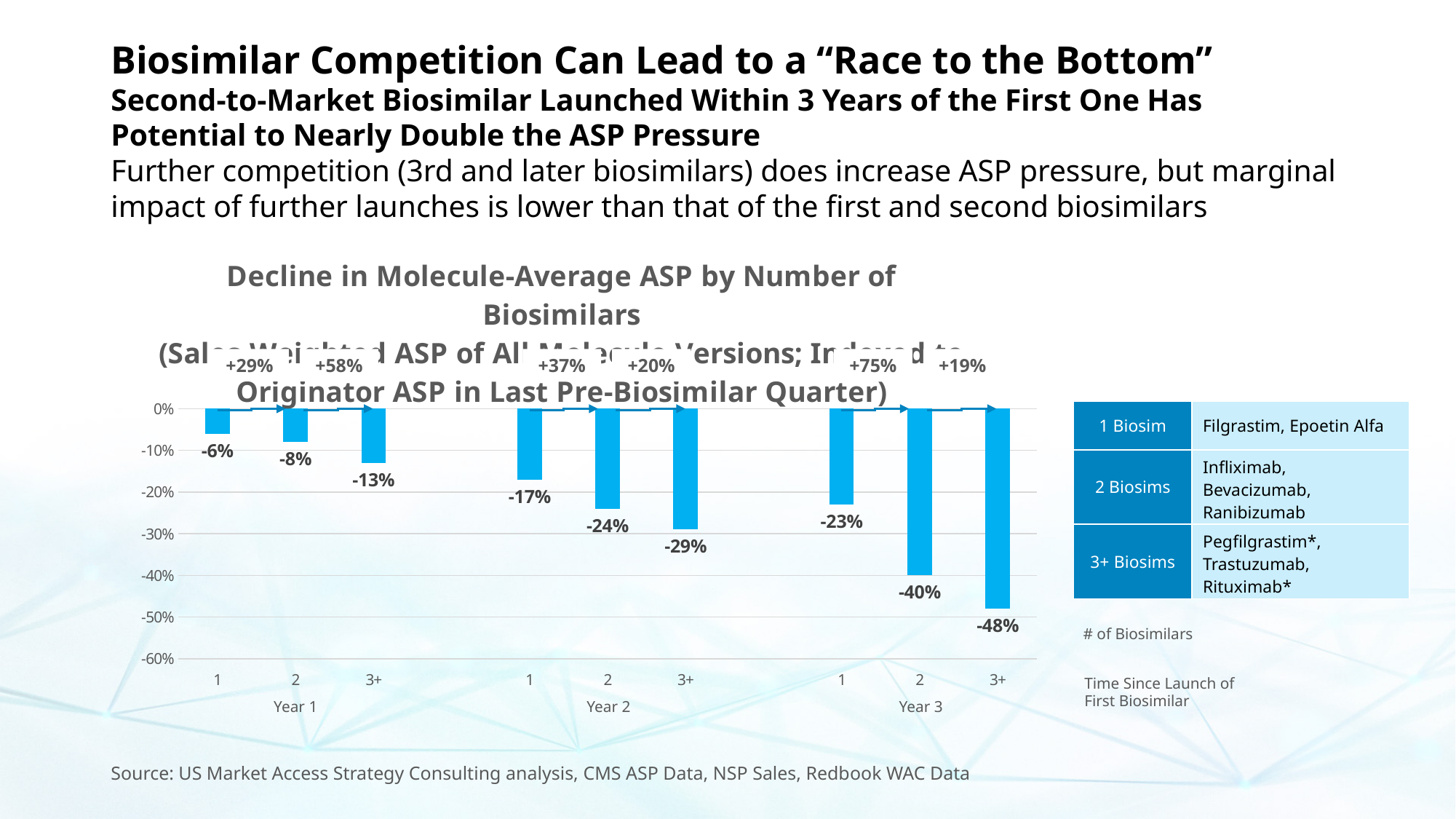
Which molecules are listed in the table for the 1 Biosim group? Filgrastim, Epoetin Alfa What is the ASP decline for 3+ biosimilars in Year 3? -48% What is the ASP decline for 1 biosimilar in Year 1? -6% Within each year, do the ASP declines get larger or smaller as the number of biosimilars increases? Larger Which bar shows the smallest ASP decline? 1 biosimilar in Year 1 Which bar shows the largest ASP decline? 3+ biosimilars in Year 3 How many bars are plotted in the chart? 9 What is the ASP decline for 2 biosimilars in Year 2? -24% What type of chart is shown on the slide? Bar chart What is the difference in percentage points between the 2 biosimilars bar and the 1 biosimilar bar in Year 3? 17 percentage points Which shows a larger ASP decline: 3+ biosimilars in Year 2 or 2 biosimilars in Year 3? 2 biosimilars in Year 3 What is the ASP decline for 1 biosimilar in Year 3? -23%